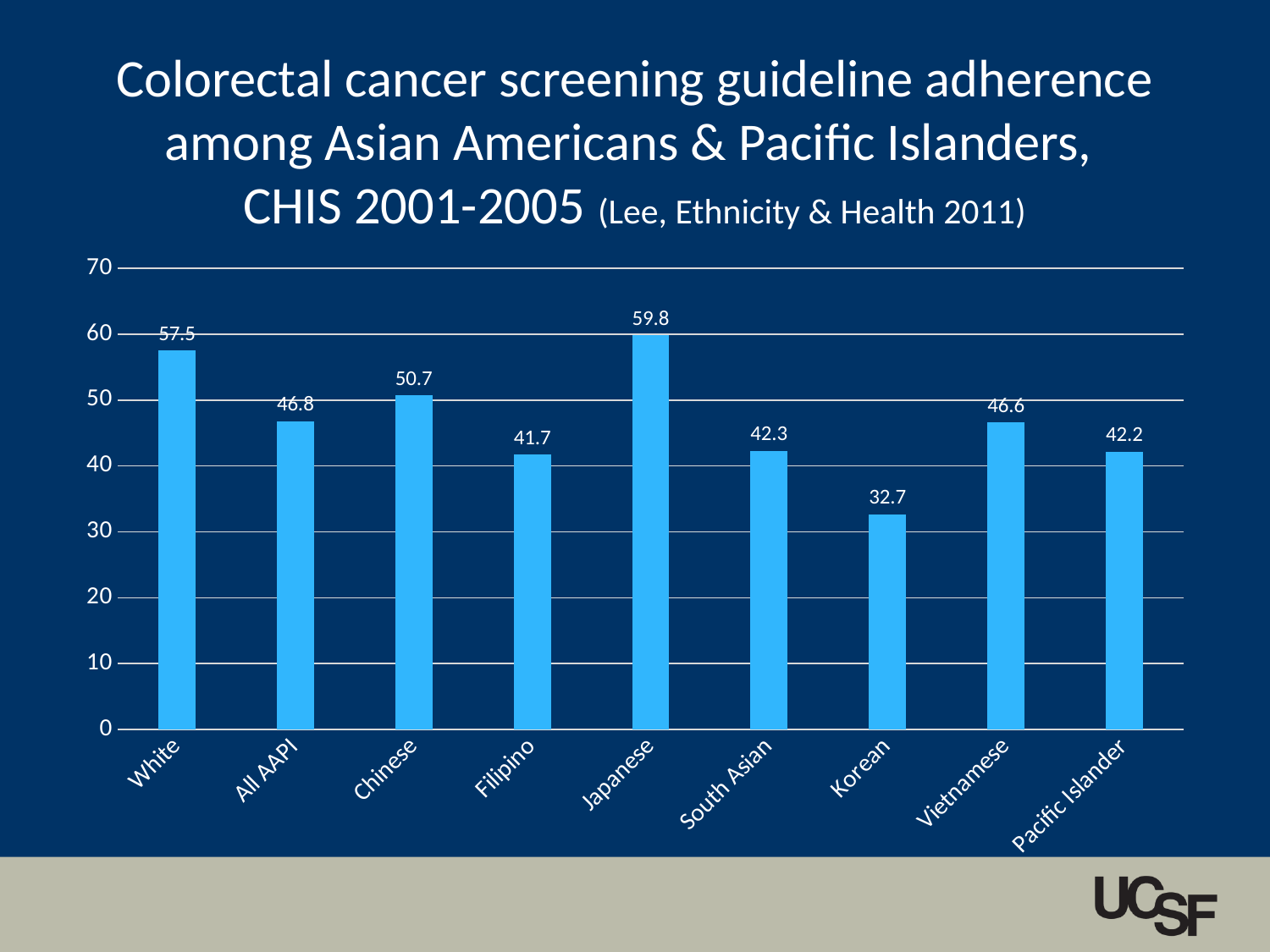
What is the value for Japanese? 59.8 Which category has the highest value? Japanese What kind of chart is shown on the slide? bar chart Is the value for Pacific Islander greater or less than 50? less How many categories are shown on the x axis? 9 What is the highest value shown on the y axis? 70 What is the value for Korean? 32.7 What is the difference between the values for White and Korean? 24.8 Which category has the lowest value? Korean What is the difference between the values for Japanese and Chinese? 9.1 Which is larger, the value for Filipino or the value for Vietnamese? Vietnamese What is the value for All AAPI? 46.8